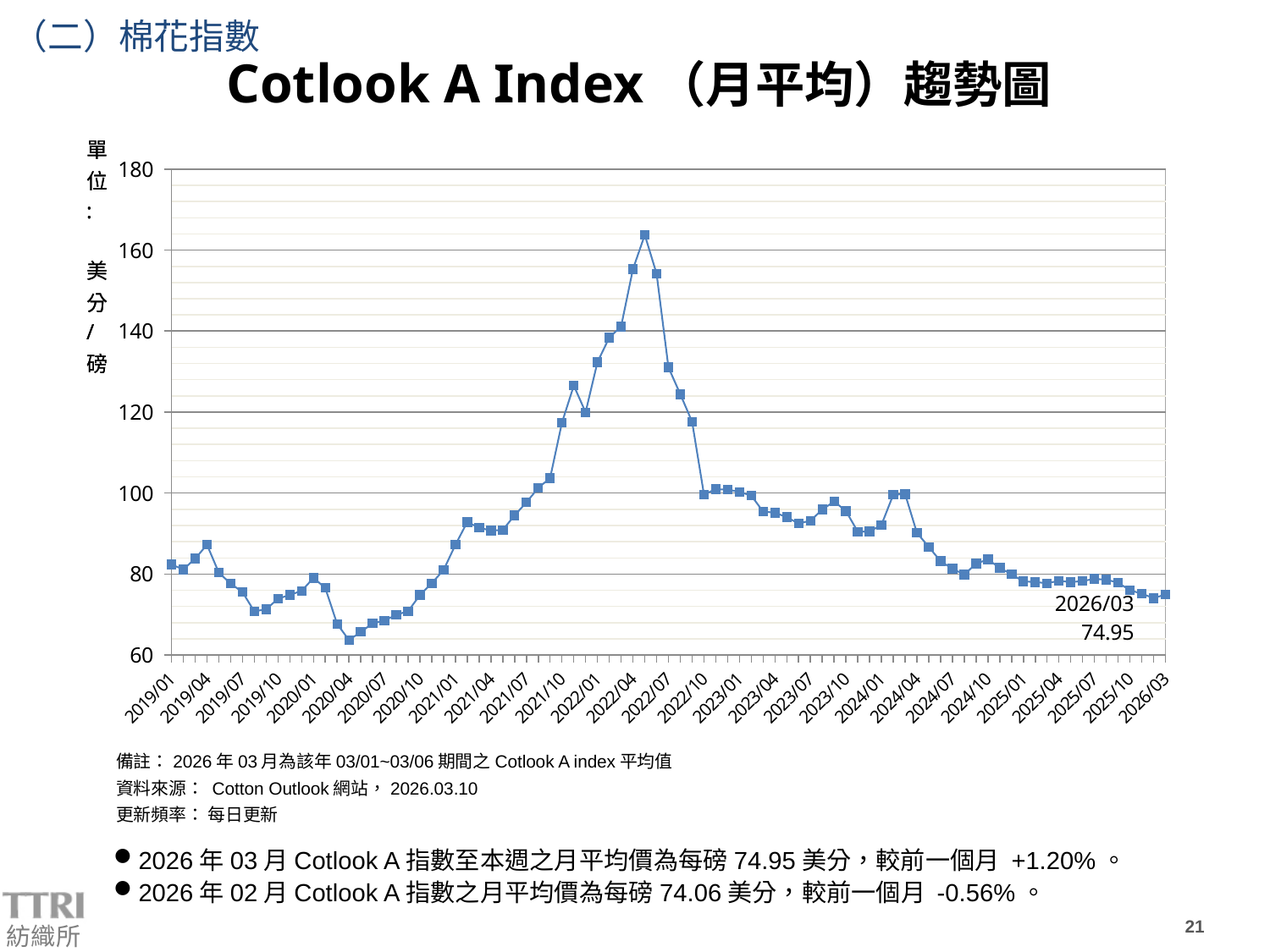
In which year does the Cotlook A Index reach its lowest point on the chart? 2020 What unit is shown on the y axis of the chart? 美分/磅 What is the value of the Cotlook A Index for 2026/03 as labelled on the chart? 74.95 Is the value for 2022/04 greater or less than 140? greater What kind of chart is used to show the Cotlook A Index trend? line chart Is the value for 2020/04 greater or less than 70? less Does the index rise or fall between 2021/01 and 2022/04? rise Which is larger, the value for 2020/04 or the value for 2024/04? 2024/04 In which year does the Cotlook A Index reach its highest point on the chart? 2022 Does the index rise or fall between 2022/04 and 2022/10? fall Is the peak value of the index greater or less than 160? greater